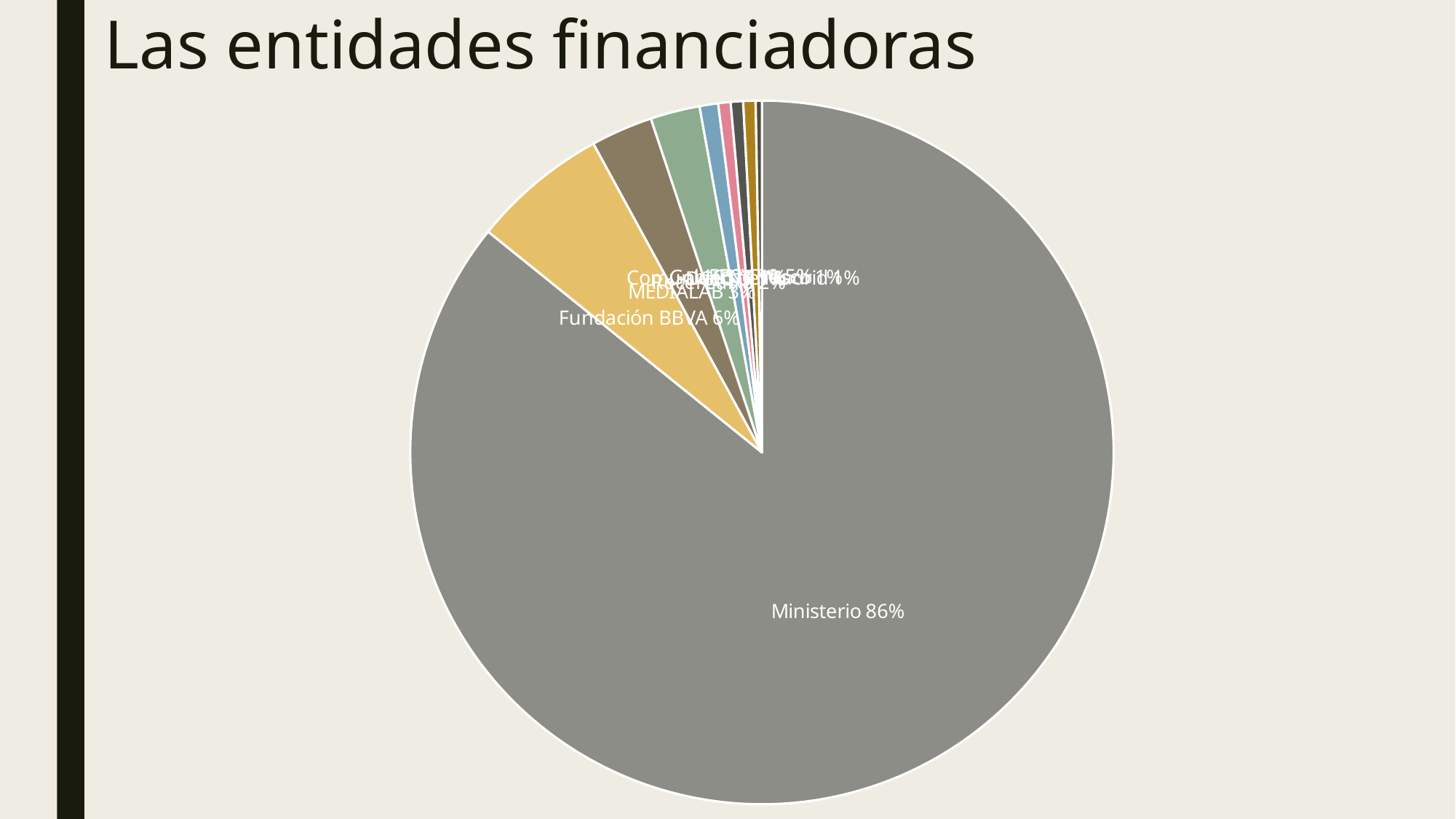
What colour is the slice for Fundación BBVA? Yellow By how many percentage points does Fundación BBVA exceed MEDIALAB? 3 percentage points What is the title of the slide containing the chart? Las entidades financiadoras What share of the pie does Ministerio hold? 86% By how many percentage points does Ministerio exceed Fundación BBVA? 80 percentage points What kind of chart is shown on the slide? Pie chart Which is larger, the slice for Fundación BBVA or the slice for MEDIALAB? Fundación BBVA Which is larger, the slice for Ministerio or the slice for Fundación BBVA? Ministerio What percentage is shown for MEDIALAB? 3% Which entity has the largest slice of the pie? Ministerio What percentage is shown for Fundación BBVA? 6%